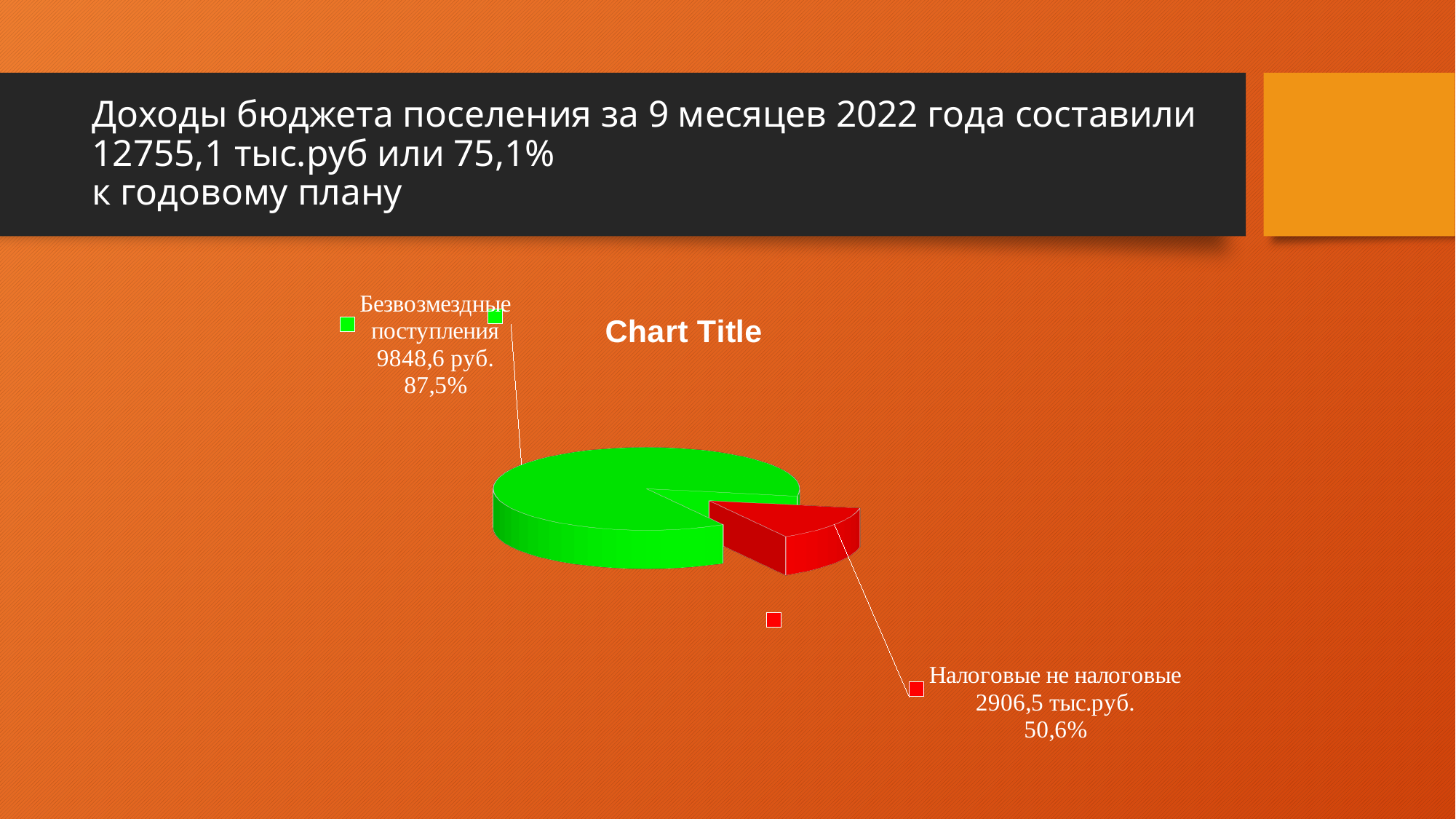
What kind of chart is shown on the slide? pie chart Which slice of the pie chart is the smallest? Налоговые не налоговые What percentage is printed next to the "Безвозмездные поступления" slice? 87,5% Which slice of the pie chart is the largest? Безвозмездные поступления Which is larger: the value for "Безвозмездные поступления" or the value for "Налоговые не налоговые"? Безвозмездные поступления What percentage is printed next to the "Налоговые не налоговые" slice? 50,6% What value is printed for the slice labelled "Безвозмездные поступления"? 9848,6 руб. What is the difference between the values 9848,6 and 2906,5 printed on the pie chart? 6942,1 What colour is the slice labelled "Налоговые не налоговые"? red How many slices does the pie chart have? 2 What value is printed for the slice labelled "Налоговые не налоговые"? 2906,5 тыс.руб. What is the title of the chart? Chart Title